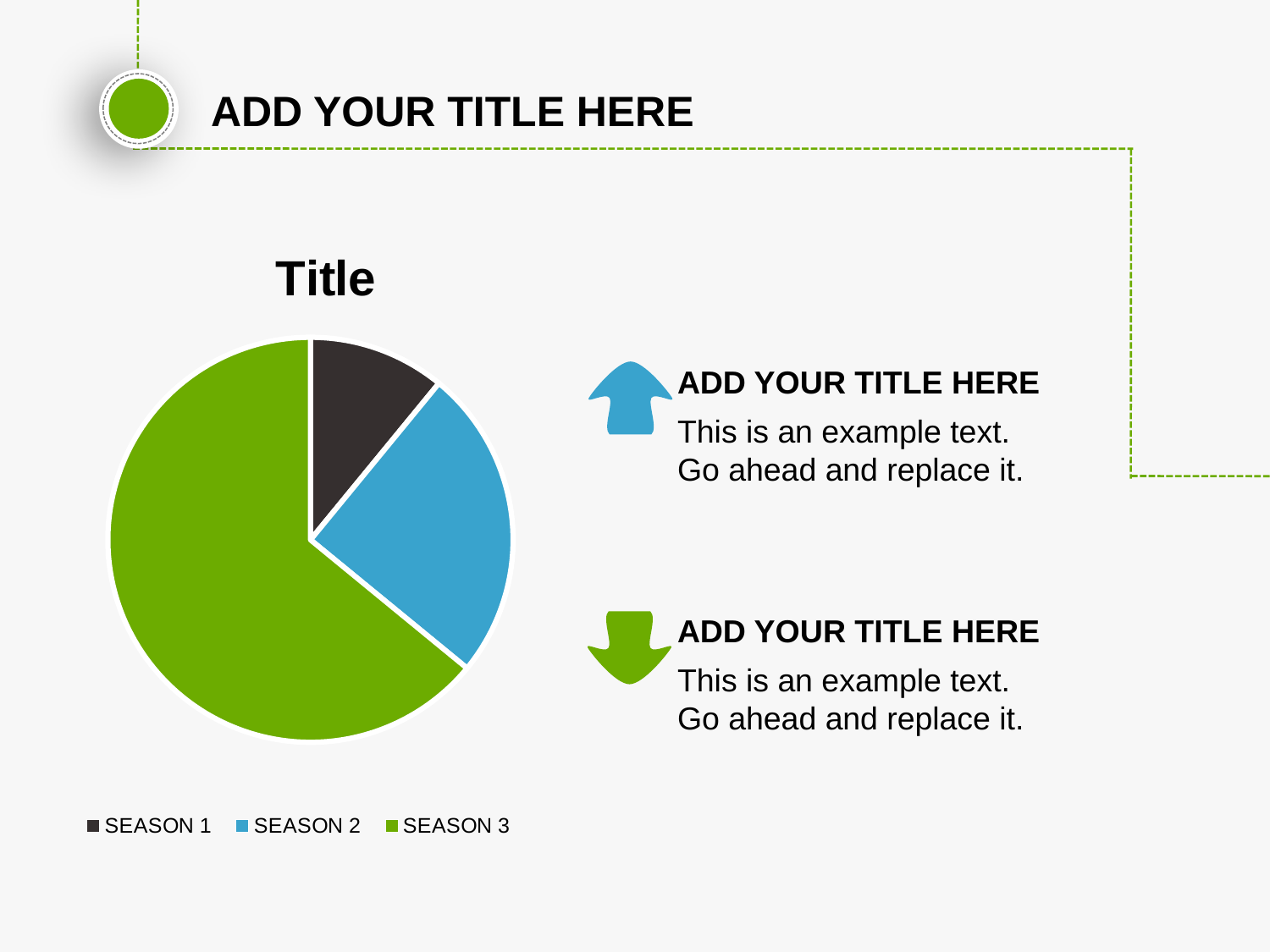
Which slice is larger, SEASON 3 or SEASON 2? SEASON 3 How many slices does the pie chart have? 3 What is the title of the chart? Title Which category has the smallest slice of the pie? SEASON 1 How many entries does the legend list? 3 Which category has the largest slice of the pie? SEASON 3 Does the SEASON 3 slice take up more or less than half of the pie? more Which slice is larger, SEASON 2 or SEASON 1? SEASON 2 What kind of chart is shown on the slide? pie chart What colour is the SEASON 3 slice? green